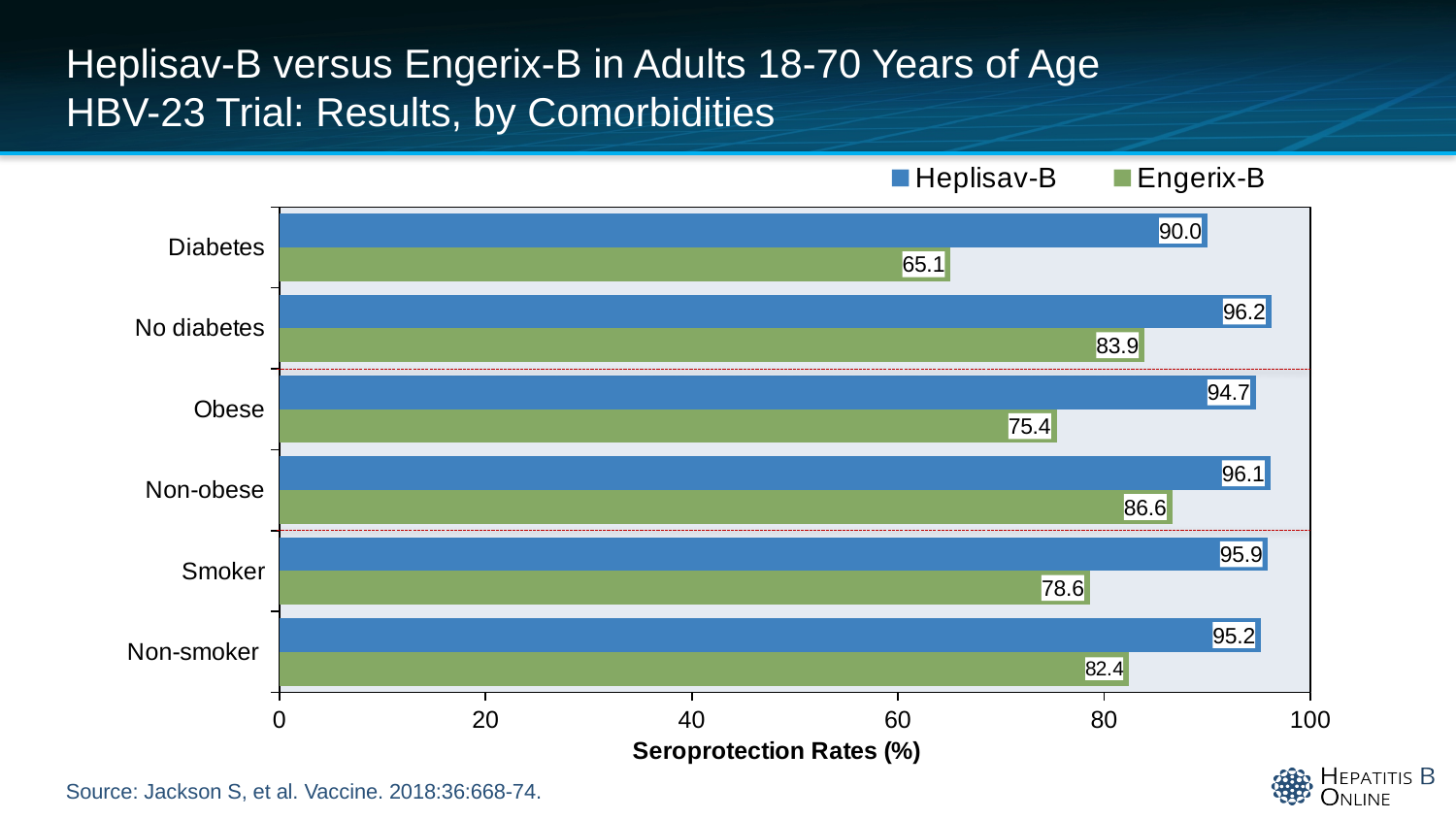
Which group has the highest Heplisav-B seroprotection rate? No diabetes What kind of chart is shown on the slide? bar chart Is the Engerix-B seroprotection rate for the Diabetes group greater or less than 80? less What is the Heplisav-B seroprotection rate for the Diabetes group? 90.0 How many series does the legend list? 2 What is the difference between the Heplisav-B and Engerix-B seroprotection rates for the Diabetes group? 24.9 Which group has the lowest Engerix-B seroprotection rate? Diabetes Which is larger, the Engerix-B rate for Non-obese or the Engerix-B rate for Smoker? Non-obese How many comorbidity groups are shown on the chart? 6 What is the Engerix-B seroprotection rate for the Obese group? 75.4 What is the Engerix-B seroprotection rate for Non-smokers? 82.4 What is the difference between the Heplisav-B and Engerix-B seroprotection rates for the Smoker group? 17.3